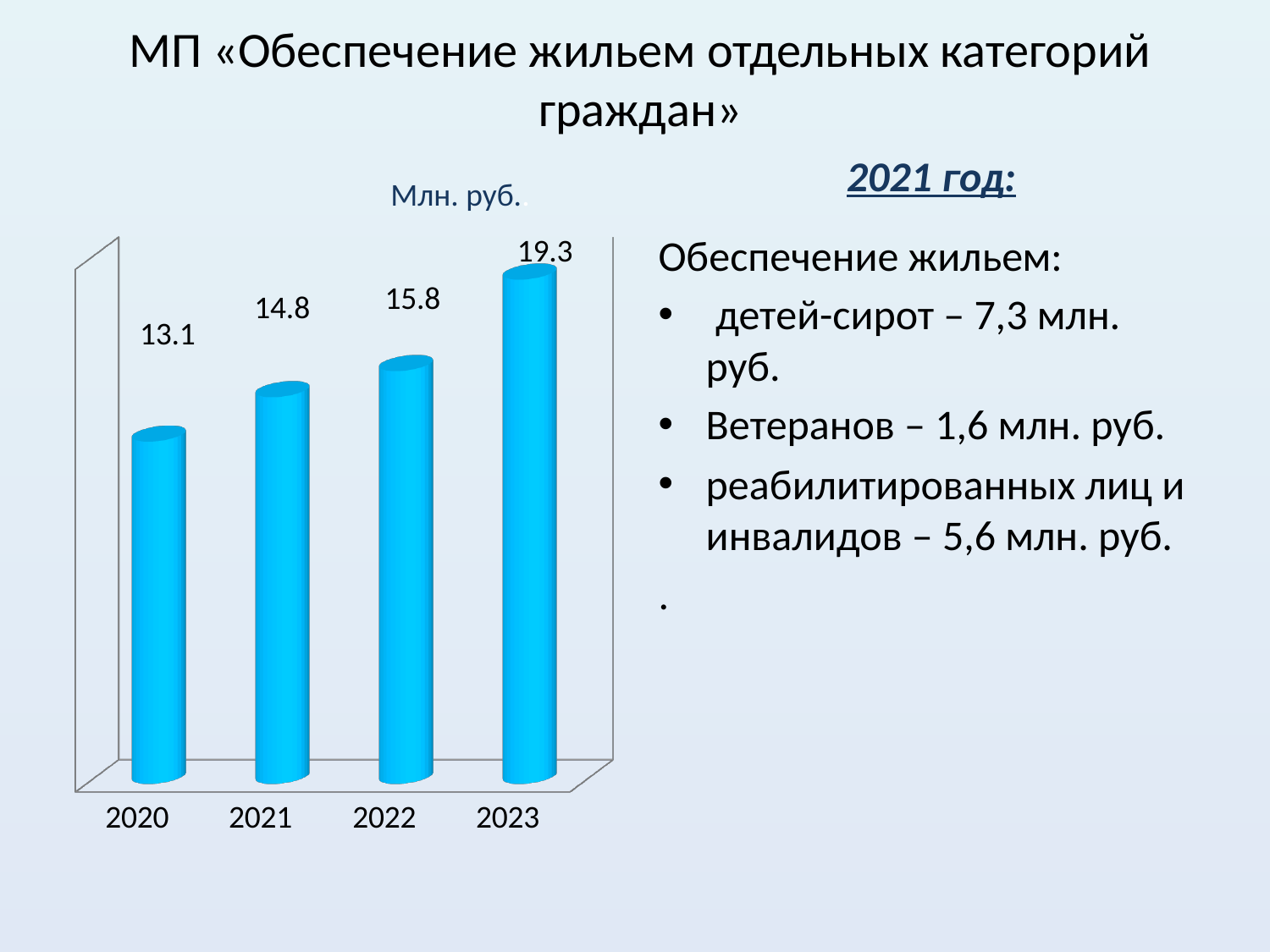
What is the value for 2023? 19.3 Which is larger, the value for 2021 or the value for 2022? 2022 What is the value for 2020? 13.1 What is the value for 2022? 15.8 What is the difference between the values for 2023 and 2020? 6.2 Do the values rise or fall from 2020 to 2023? rise What is the value for 2021? 14.8 Which year has the lowest value? 2020 Which year has the highest value? 2023 What is the difference between the values for 2022 and 2021? 1.0 How many years are shown on the chart? 4 What kind of chart is shown on the slide? bar chart